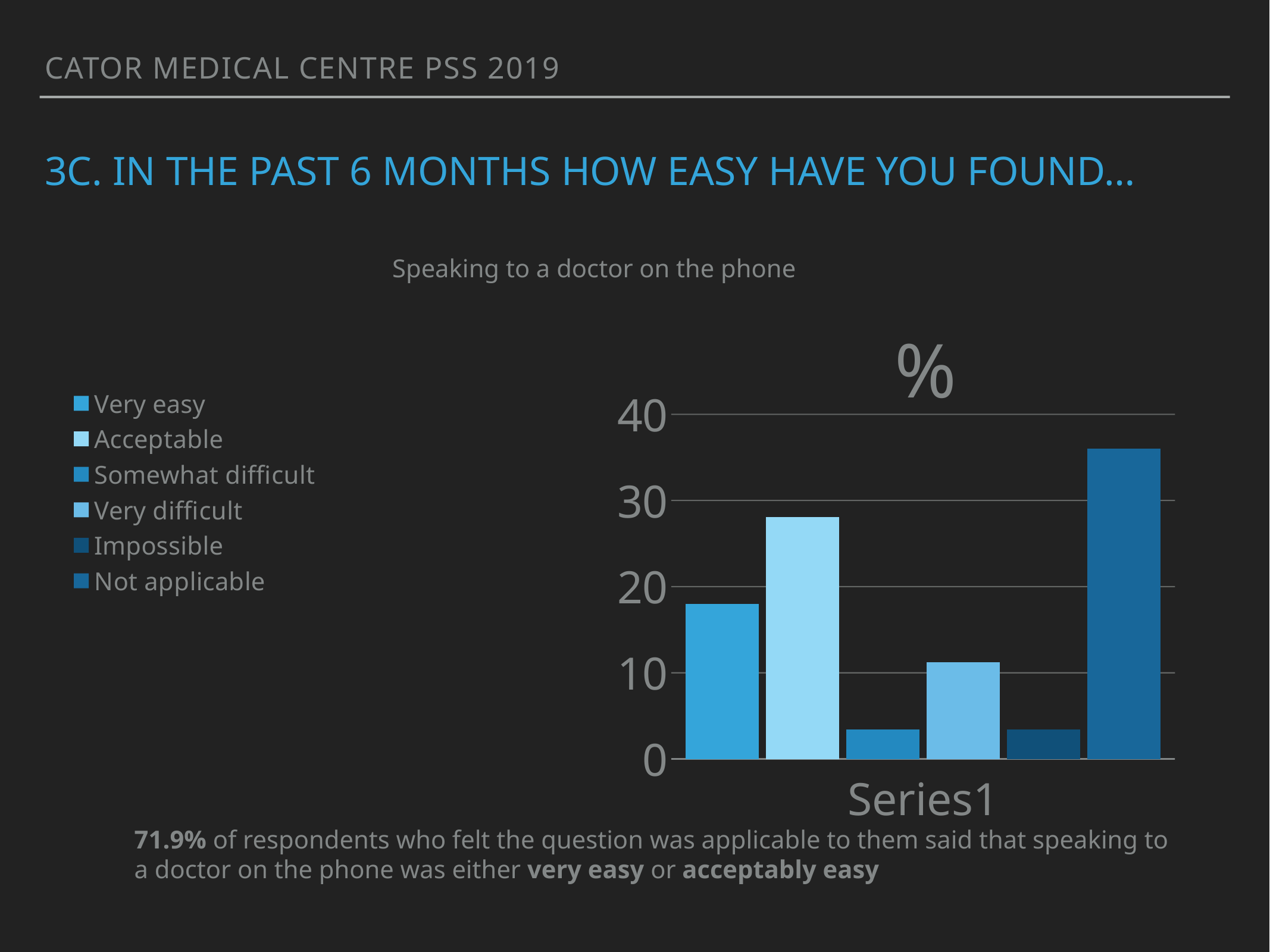
Is the value for Acceptable greater or less than 20? greater Which is larger, the value for Not applicable or the value for Acceptable? Not applicable Which response has the highest bar in the chart? Not applicable Which is larger, the value for Very easy or the value for Very difficult? Very easy Is the value for Very easy greater or less than 20? less What is the title shown above the chart's plot area? % Is the value for Very difficult greater or less than 20? less Which is larger, the value for Acceptable or the value for Very easy? Acceptable How many series does the chart legend list? 6 What kind of chart is shown on the slide? bar chart